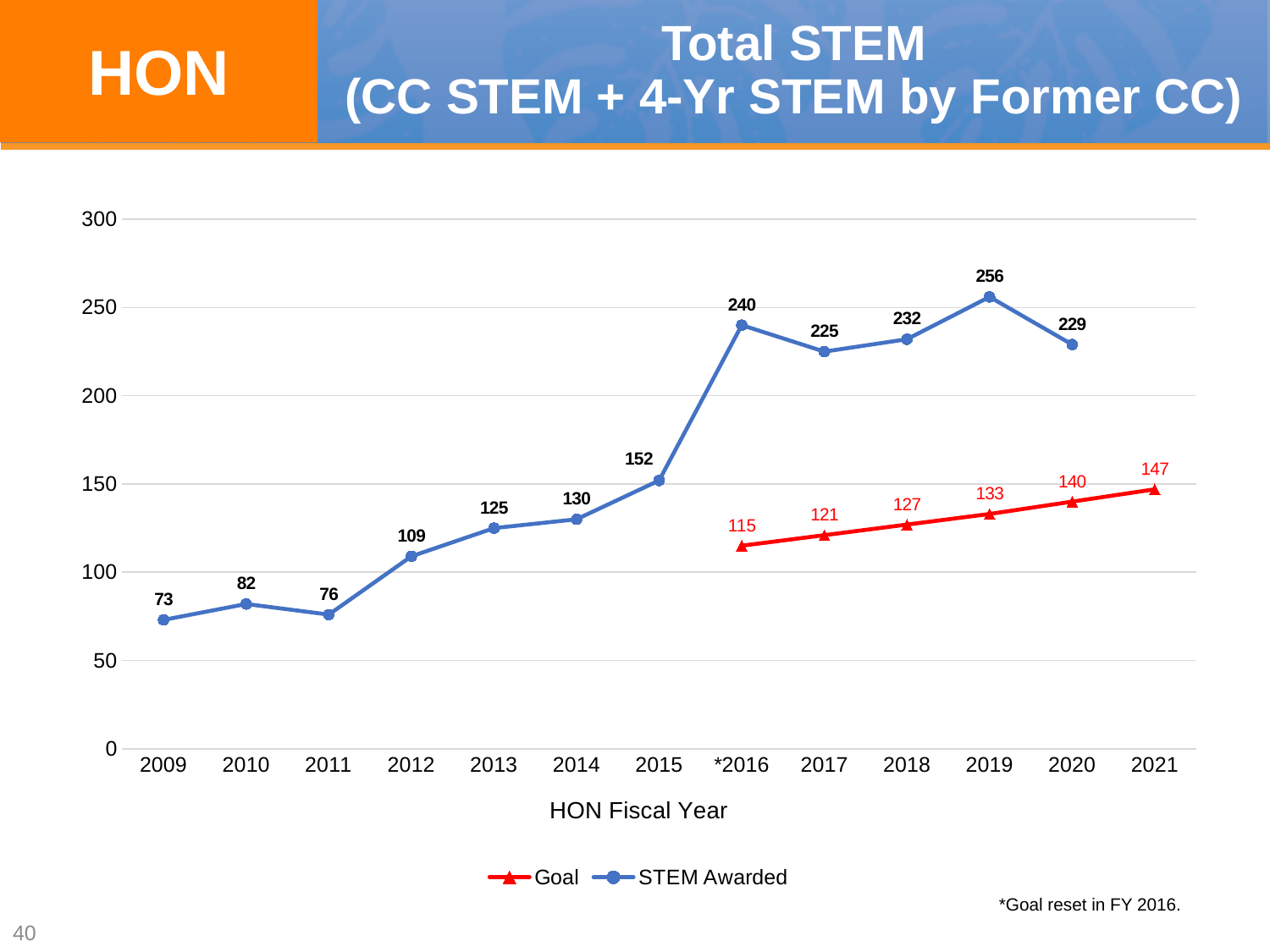
What kind of chart is shown on the slide? line chart What is the Goal value for 2021? 147 How many years are shown on the x axis? 13 Is the STEM Awarded value for 2012 greater or less than 100? greater Which is larger, the STEM Awarded value for 2015 or the STEM Awarded value for 2014? 2015 In which year is the STEM Awarded value highest? 2019 Does the Goal series rise or fall from 2016 to 2021? rise How many series does the legend list? 2 What is the STEM Awarded value for 2009? 73 What is the difference between the STEM Awarded value and the Goal value in 2020? 89 What is the STEM Awarded value for 2019? 256 In which year is the STEM Awarded value lowest? 2009